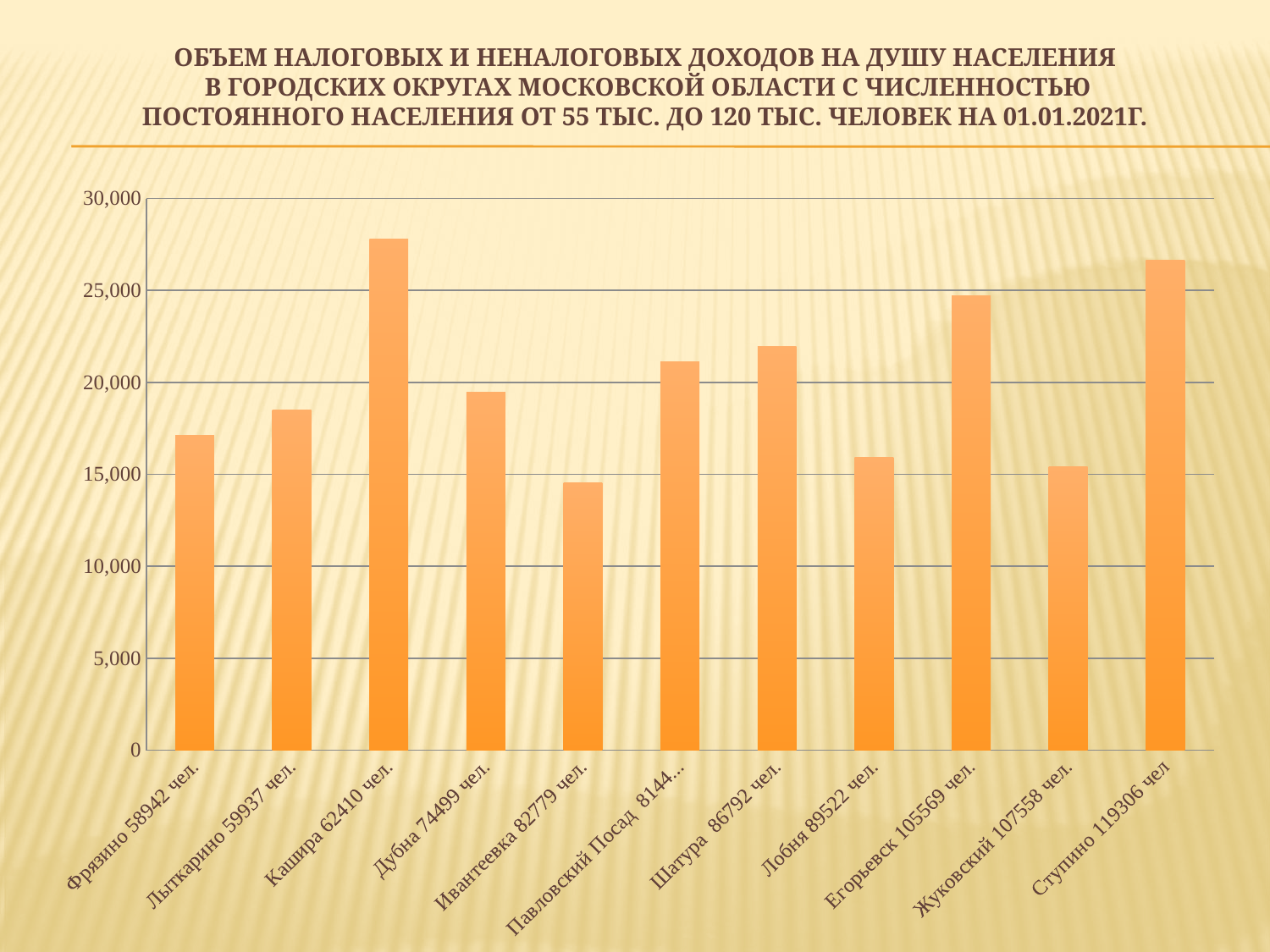
What kind of chart is shown on the slide? bar chart Which city district has the lowest value on the chart? Ивантеевка 82779 чел. Is the value for Шатура greater or less than 20,000? greater Which city district has the highest value on the chart? Кашира 62410 чел. How many city districts (categories) are plotted on the chart? 11 What colour are the bars on the chart? orange Is the value for Кашира greater or less than 25,000? greater Is the value for Ивантеевка greater or less than 15,000? less Which has the larger value, Кашира or Ступино? Кашира Which has the larger value, Шатура or Лобня? Шатура